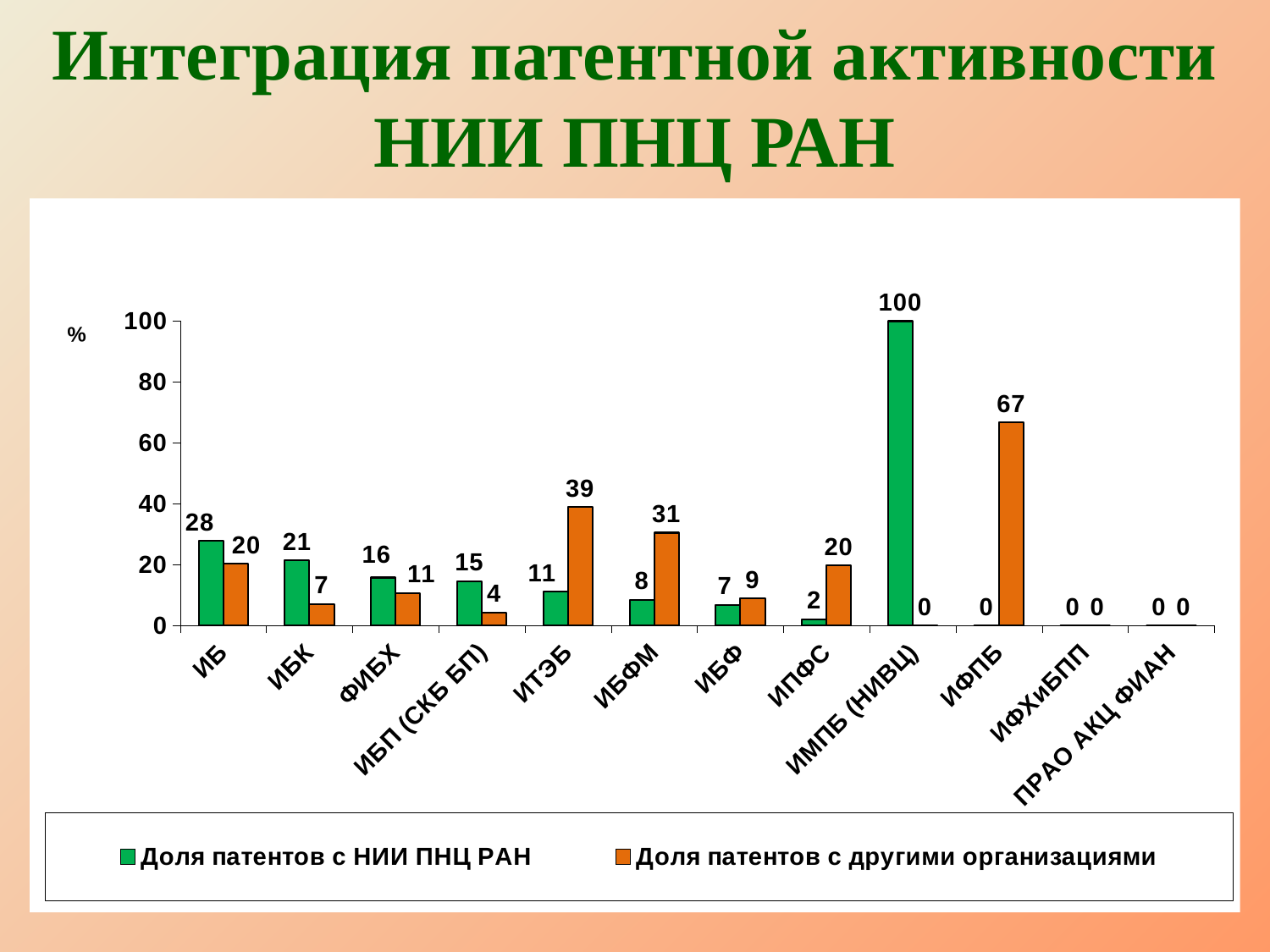
What is the value of 'Доля патентов с другими организациями' for ИТЭБ? 39 How many series does the legend list? 2 What unit is shown on the y axis label? % How many categories are shown on the x axis? 12 What is the value of 'Доля патентов с другими организациями' for ИФПБ? 67 For ИПФС, which series has the larger value: 'Доля патентов с НИИ ПНЦ РАН' or 'Доля патентов с другими организациями'? Доля патентов с другими организациями Which category has the highest value for 'Доля патентов с другими организациями'? ИФПБ What is the value of 'Доля патентов с НИИ ПНЦ РАН' for ИБ? 28 What kind of chart is shown on the slide? Bar chart What is the difference between the two series values for ИБФМ? 23 What is the value of 'Доля патентов с другими организациями' for ИБП (СКБ БП)? 4 Which category has the highest value for 'Доля патентов с НИИ ПНЦ РАН'? ИМПБ (НИВЦ)